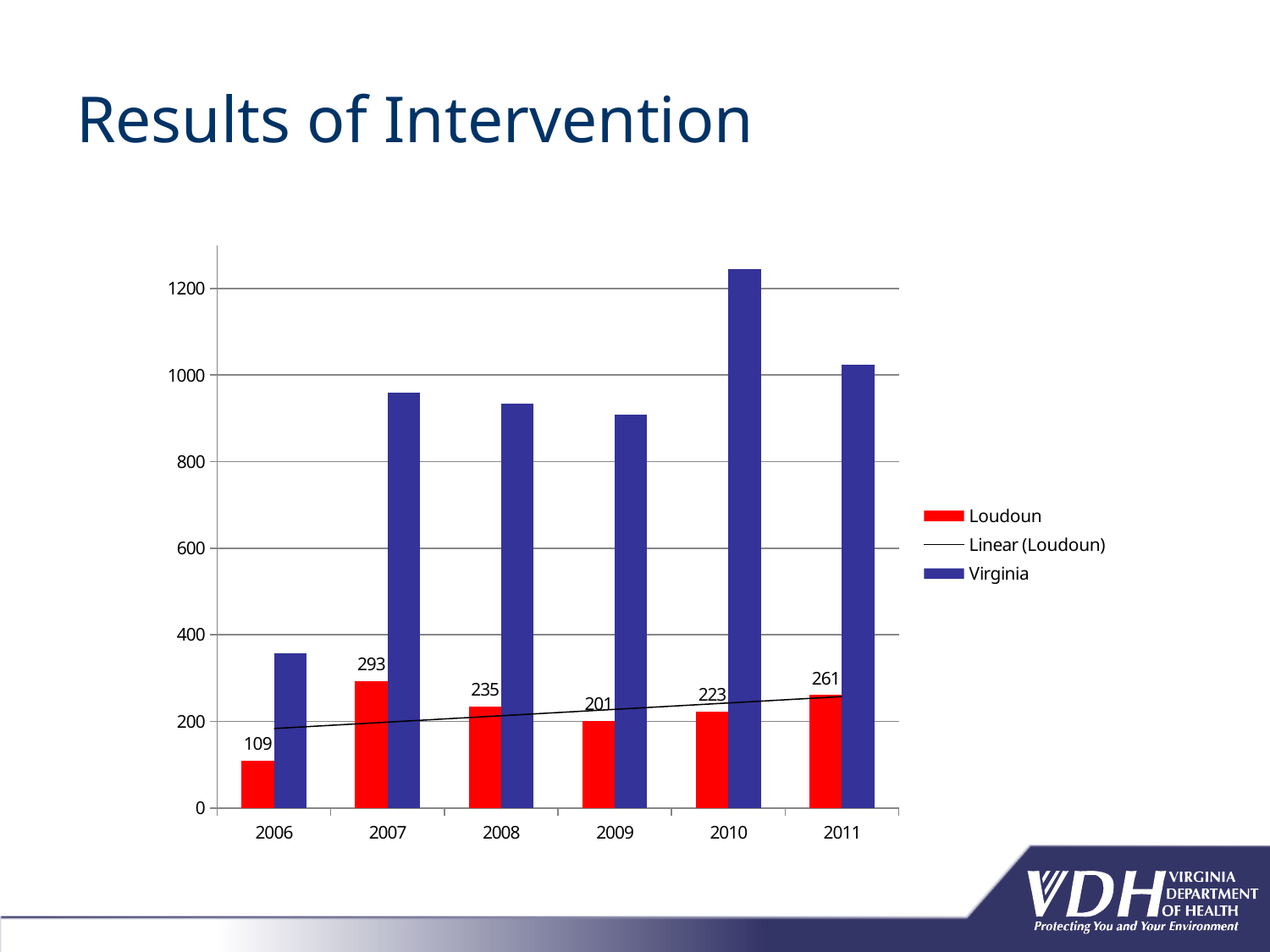
In which year is the Loudoun value highest? 2007 How many years are shown on the x axis? 6 What is the difference between the Loudoun values for 2007 and 2006? 184 Is the Virginia value for 2006 greater or less than 400? less What is the Loudoun value for 2007? 293 How many entries does the legend list? 3 What is the Loudoun value for 2006? 109 In which year is the Loudoun value lowest? 2006 Is the Virginia value for 2010 greater or less than 1200? greater What kind of chart is shown on the slide? bar chart Which year has the larger Loudoun value, 2010 or 2011? 2011 In which year is the Virginia value highest? 2010